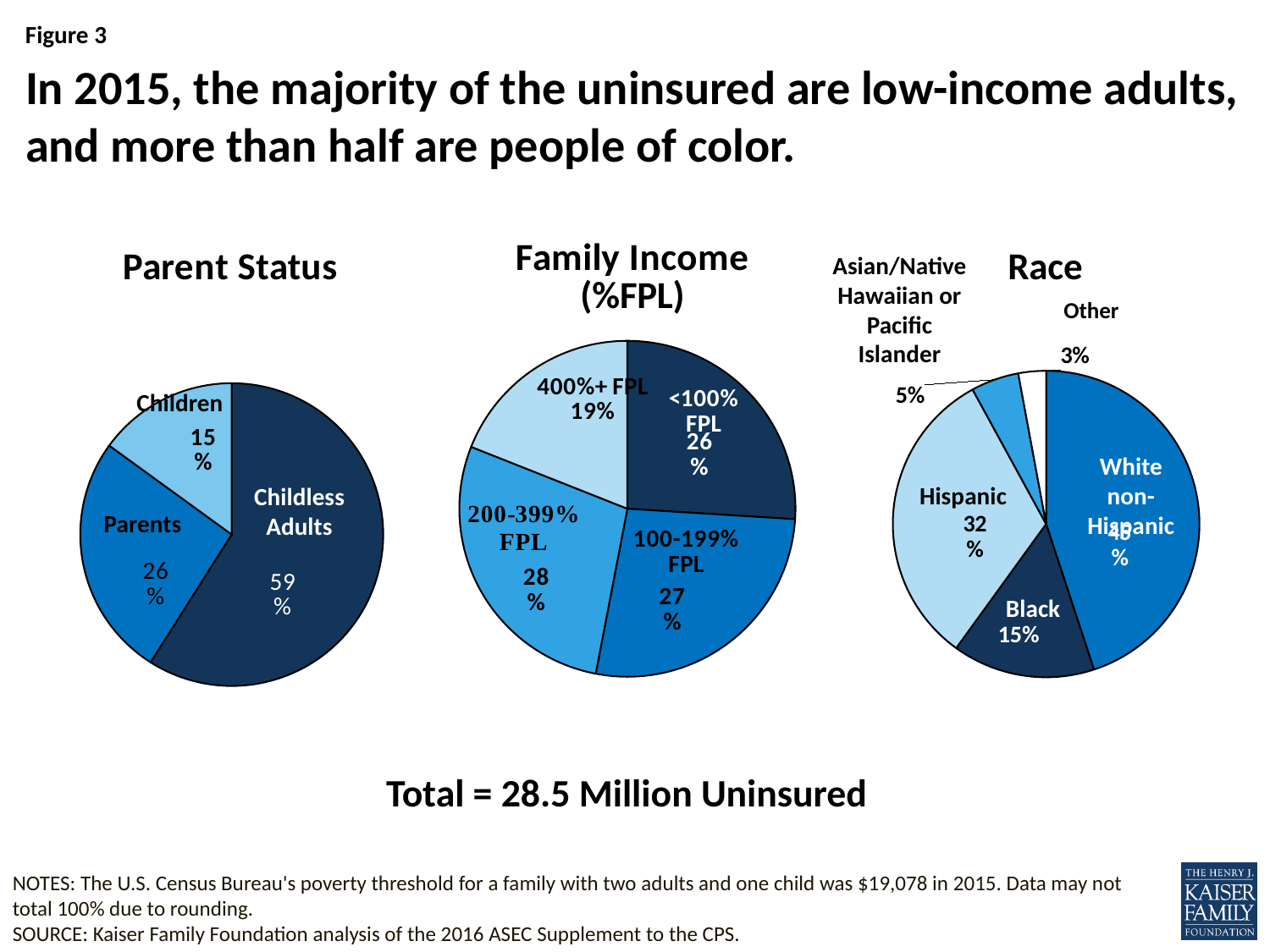
How many slices does the Family Income (%FPL) pie chart have? 4 In the Parent Status pie chart, what share of the uninsured are Childless Adults? 59% In the Race pie chart, which is larger, the Hispanic share or the Black share? Hispanic In the Family Income (%FPL) pie chart, what share of the uninsured have incomes of 400%+ FPL? 19% In the Family Income (%FPL) pie chart, what share of the uninsured have incomes of 200-399% FPL? 28% In the Parent Status pie chart, what is the difference between the Parents share and the Children share? 11% In the Parent Status pie chart, which category has the largest share? Childless Adults What type of chart is used for Parent Status, Family Income and Race on this slide? Pie chart In the Parent Status pie chart, what share of the uninsured are Children? 15% In the Race pie chart, what share of the uninsured are Hispanic? 32% In the Race pie chart, what share of the uninsured are Black? 15% In the Family Income (%FPL) pie chart, which income group has the smallest share? 400%+ FPL